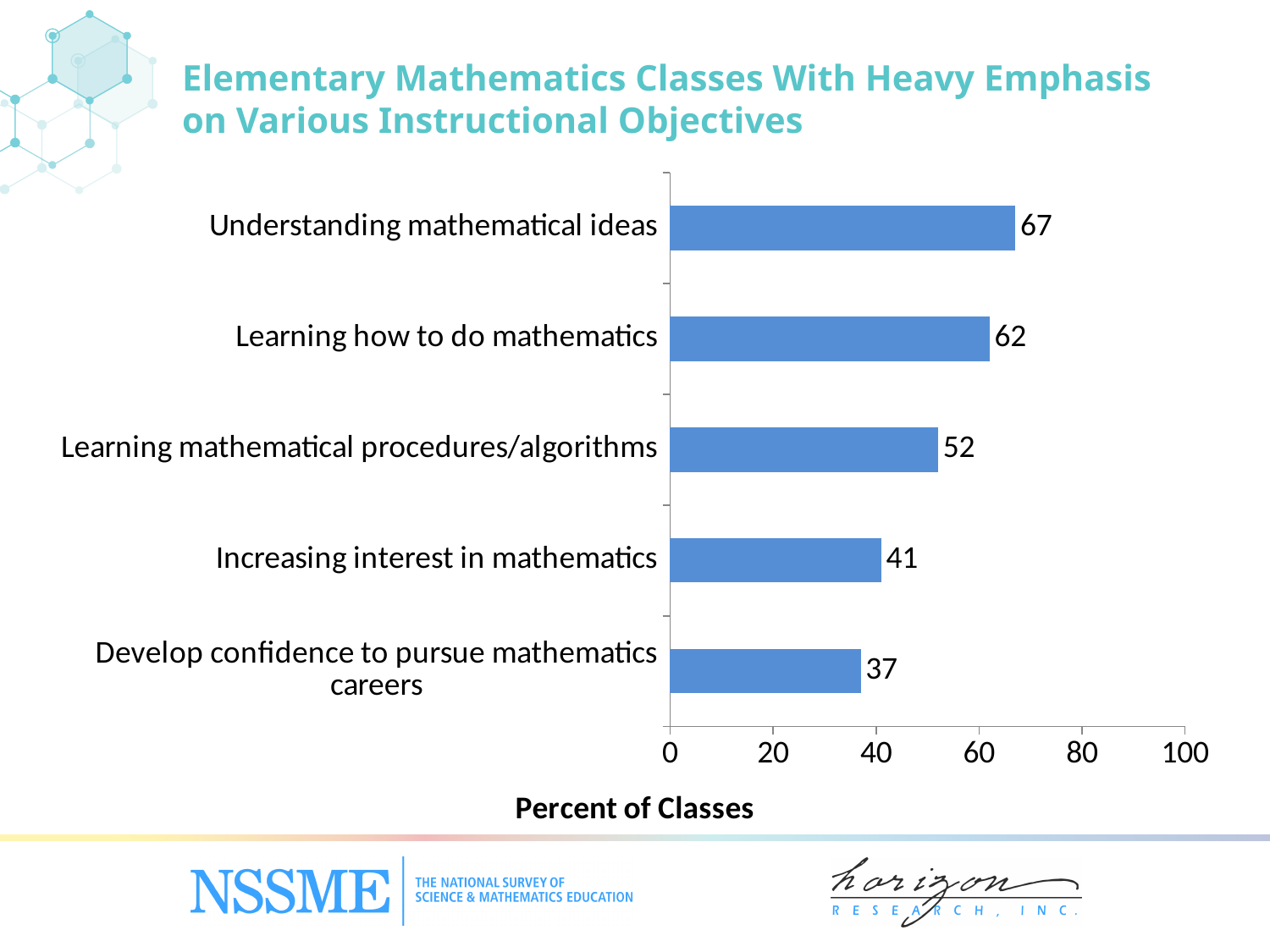
How many instructional objectives are shown in the chart? 5 Which instructional objective has the lowest percent of classes? Develop confidence to pursue mathematics careers What percent of classes place heavy emphasis on learning mathematical procedures/algorithms? 52 Which is larger: the value for 'Learning how to do mathematics' or 'Learning mathematical procedures/algorithms'? Learning how to do mathematics What is the difference between the values for 'Understanding mathematical ideas' and 'Increasing interest in mathematics'? 26 What kind of chart is shown on the slide? bar chart Which instructional objective has the highest percent of classes? Understanding mathematical ideas Is the value for 'Increasing interest in mathematics' greater or less than 60? less What is the value for 'Develop confidence to pursue mathematics careers'? 37 What is the value for 'Learning how to do mathematics'? 62 What percent of classes place heavy emphasis on understanding mathematical ideas? 67 What is the label of the horizontal axis? Percent of Classes